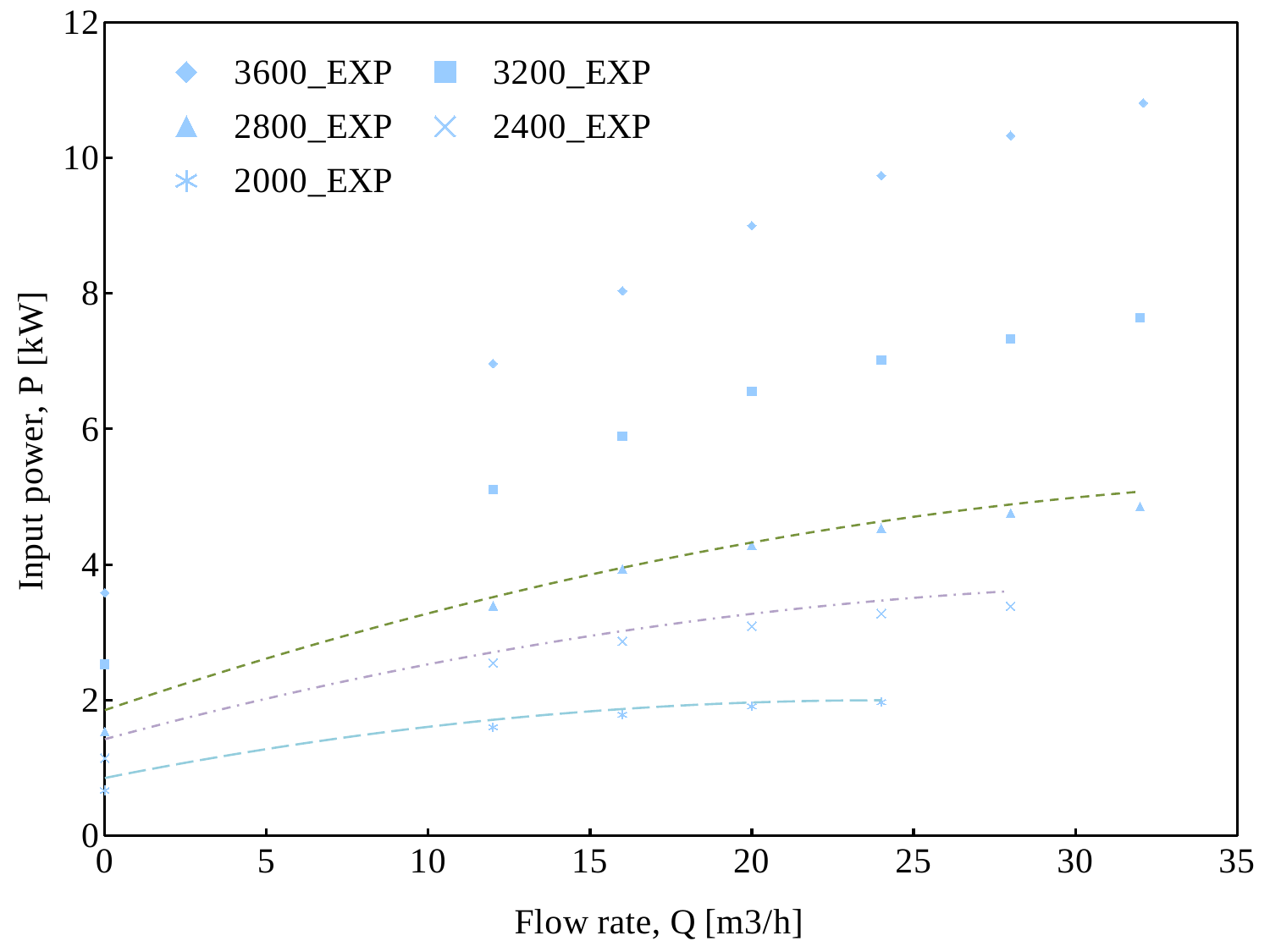
Is the value for 2800_EXP at a flow rate of 28 greater or less than 4? greater What is the label of the y axis? Input power, P [kW] At a flow rate of 20, which is larger: the value for 3600_EXP or the value for 3200_EXP? 3600_EXP How many series does the legend list? 5 Which series has the highest input power at a flow rate of 32? 3600_EXP Is the value for 3600_EXP at a flow rate of 32 greater or less than 10? greater Which series has the lowest input power at a flow rate of 24? 2000_EXP What is the label of the x axis? Flow rate, Q [m3/h] Does the input power for 3600_EXP rise or fall as the flow rate increases? rise Is the value for 2400_EXP at a flow rate of 28 greater or less than 4? less What kind of chart is shown on the slide? scatter chart